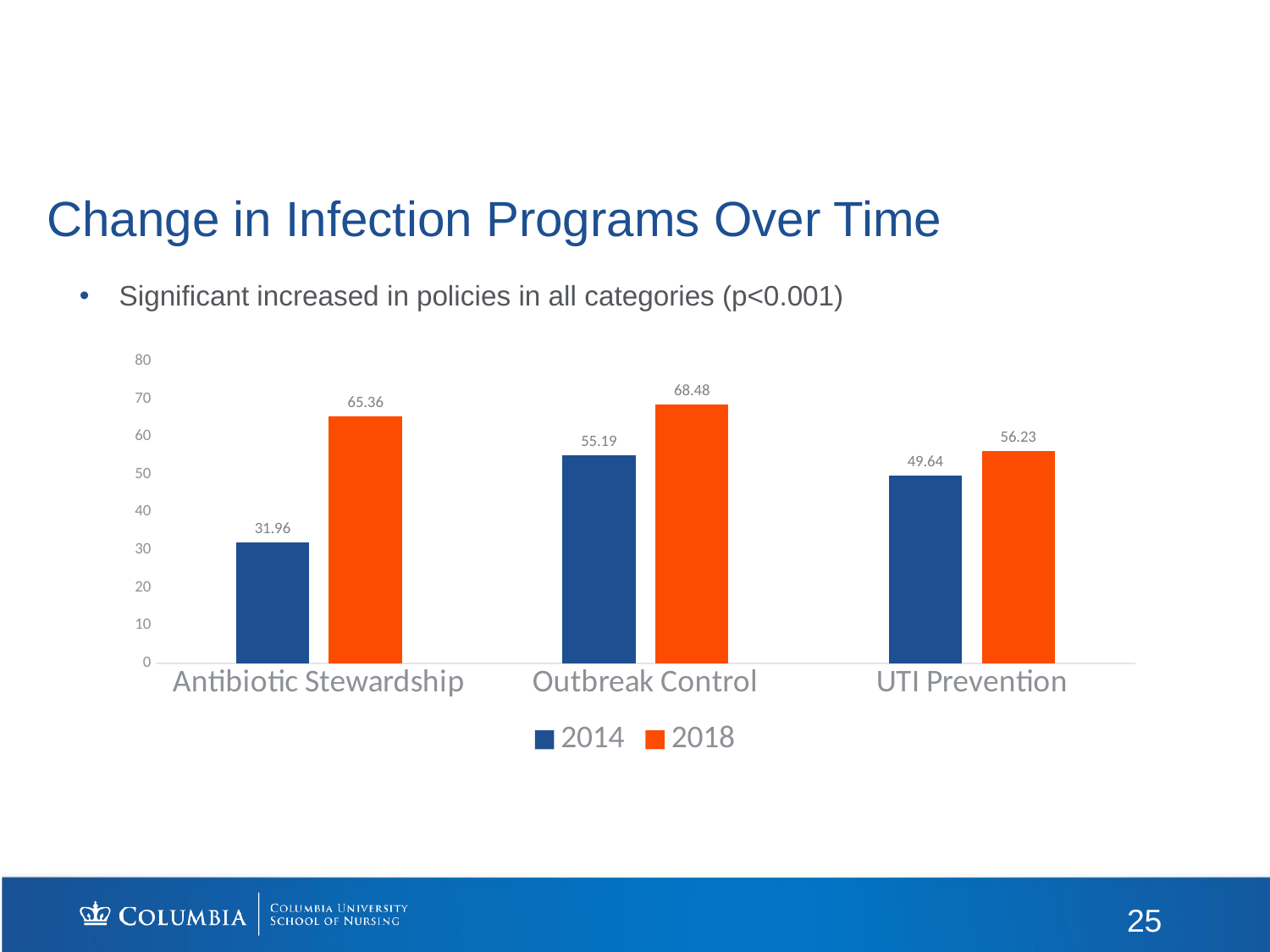
What kind of chart is shown on the slide? Bar chart How many series does the legend list? 2 Which is larger: the 2014 value for Outbreak Control or the 2018 value for UTI Prevention? 2018 value for UTI Prevention What is the 2014 value for Antibiotic Stewardship? 31.96 Which category has the highest 2018 value? Outbreak Control Which category has the lowest 2014 value? Antibiotic Stewardship What is the difference between the 2018 and 2014 values for Antibiotic Stewardship? 33.40 What is the difference between the 2018 and 2014 values for UTI Prevention? 6.59 Which series is shown in orange in the legend? 2018 What is the 2014 value for UTI Prevention? 49.64 How many categories are shown on the x axis? 3 What is the 2018 value for Outbreak Control? 68.48